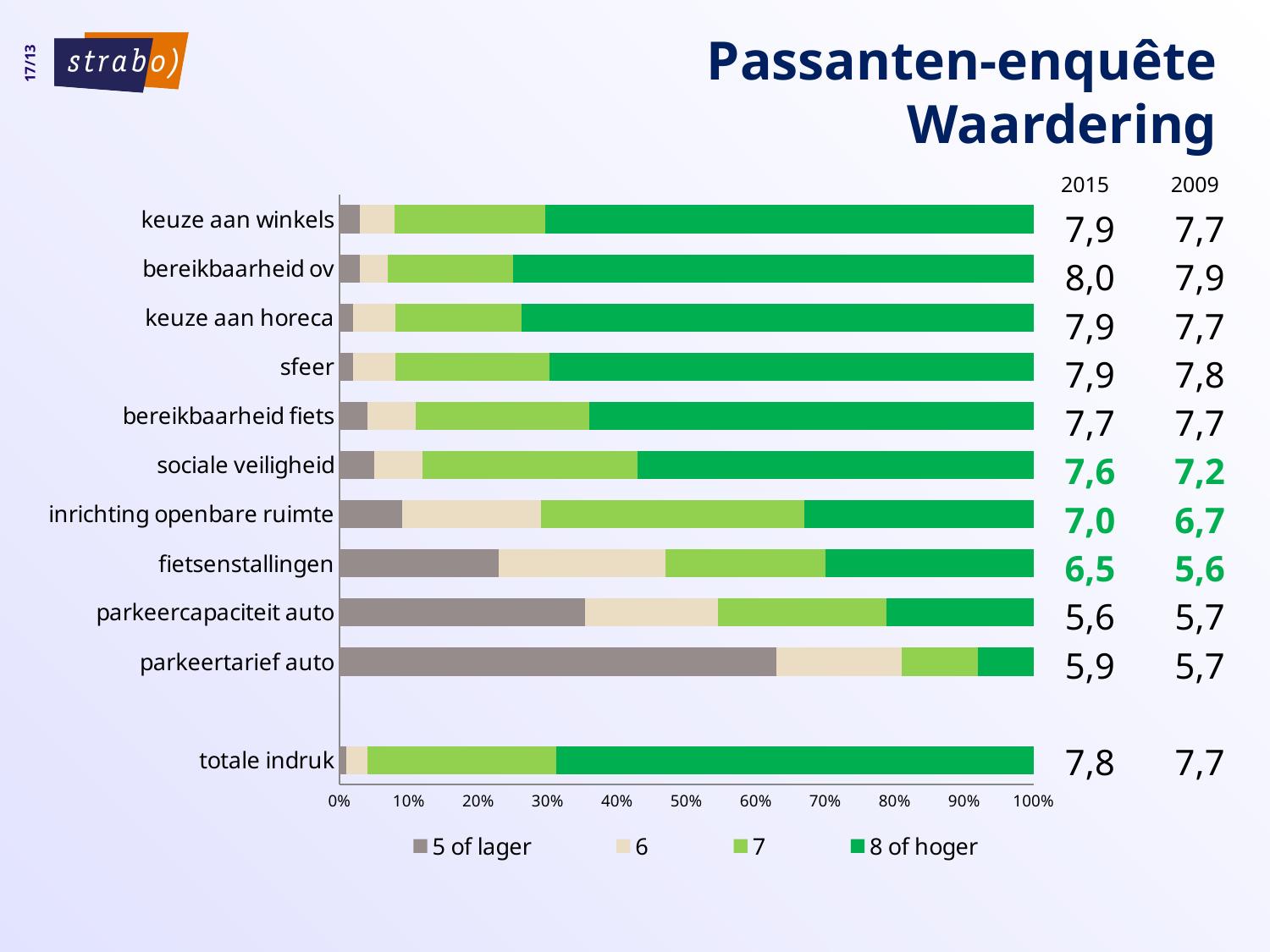
What kind of chart is shown on the slide? stacked bar chart Which has the larger '5 of lager' share: fietsenstallingen or parkeercapaciteit auto? parkeercapaciteit auto Which has the larger '8 of hoger' share: sociale veiligheid or inrichting openbare ruimte? sociale veiligheid Is the '8 of hoger' share for parkeertarief auto greater or less than 10%? less How many categories are plotted on the chart? 11 What is the 2015 score shown next to the chart for sociale veiligheid? 7,6 Is the '5 of lager' share for parkeertarief auto greater or less than 50%? greater What are the four legend entries of the chart? 5 of lager, 6, 7, 8 of hoger Which category has the largest '5 of lager' share? parkeertarief auto Is the '5 of lager' share for parkeercapaciteit auto greater or less than 30%? greater Which category has the smallest '8 of hoger' share? parkeertarief auto How many series does the chart legend list? 4